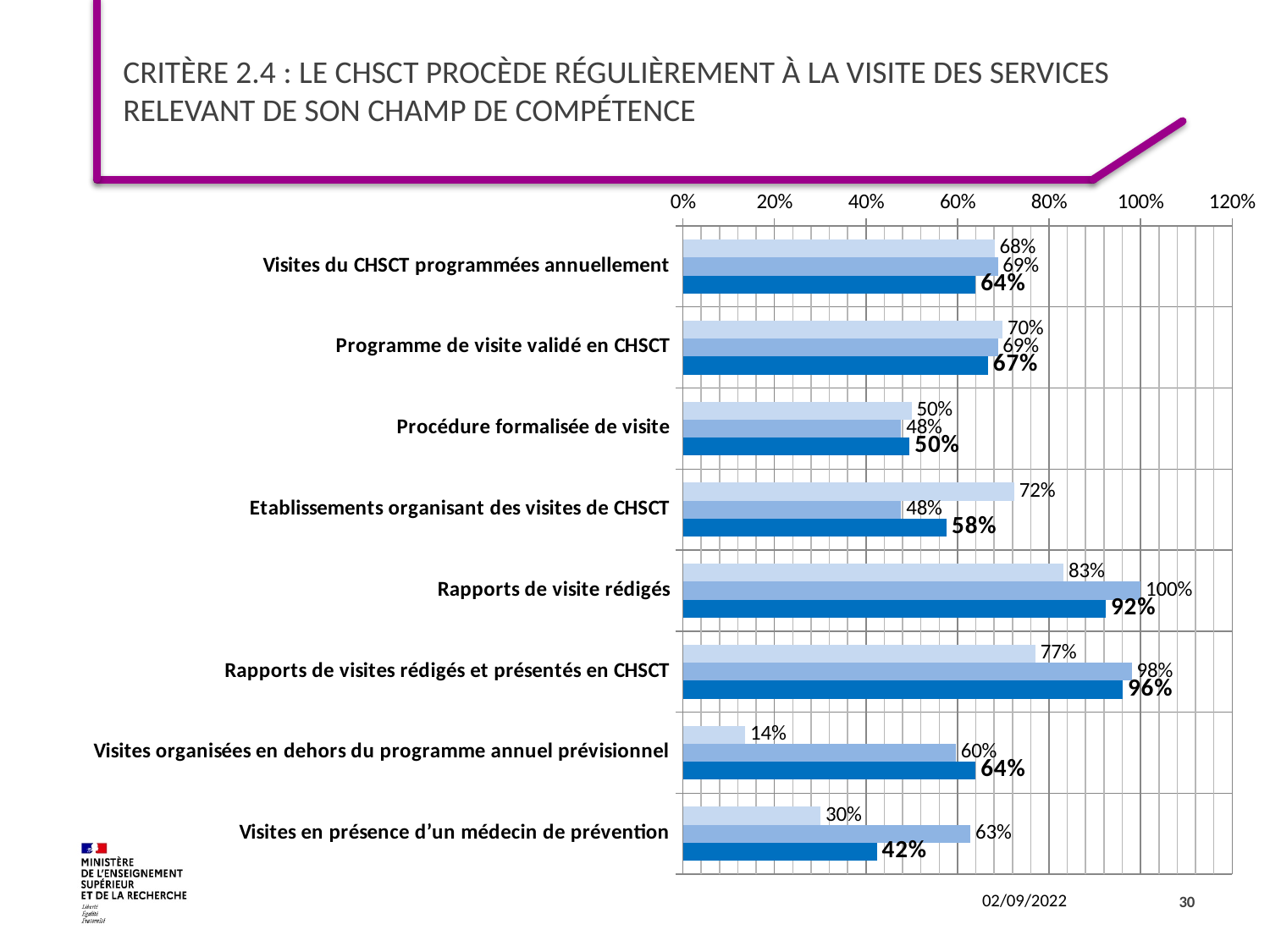
What is the value of the dark blue (bottom) bar for "Rapports de visite rédigés"? 92% What is the difference between the medium blue (middle) bar and the light blue (top) bar for "Etablissements organisant des visites de CHSCT"? 24% What is the highest value shown on the horizontal axis? 120% How many categories are shown on the chart? 8 What kind of chart is shown on the slide? bar chart Which category has the highest value for the dark blue (bottom) bar? Rapports de visites rédigés et présentés en CHSCT Which category has the lowest value for the light blue (top) bar? Visites organisées en dehors du programme annuel prévisionnel What is the value of the light blue (top) bar for "Visites organisées en dehors du programme annuel prévisionnel"? 14% For "Visites en présence d'un médecin de prévention", which is larger: the light blue (top) bar or the dark blue (bottom) bar? the dark blue (bottom) bar What is the value of the light blue (top) bar for "Programme de visite validé en CHSCT"? 70% What is the value of the medium blue (middle) bar for "Visites en présence d'un médecin de prévention"? 63% Is the medium blue (middle) bar for "Rapports de visites rédigés et présentés en CHSCT" greater or less than 80%? greater